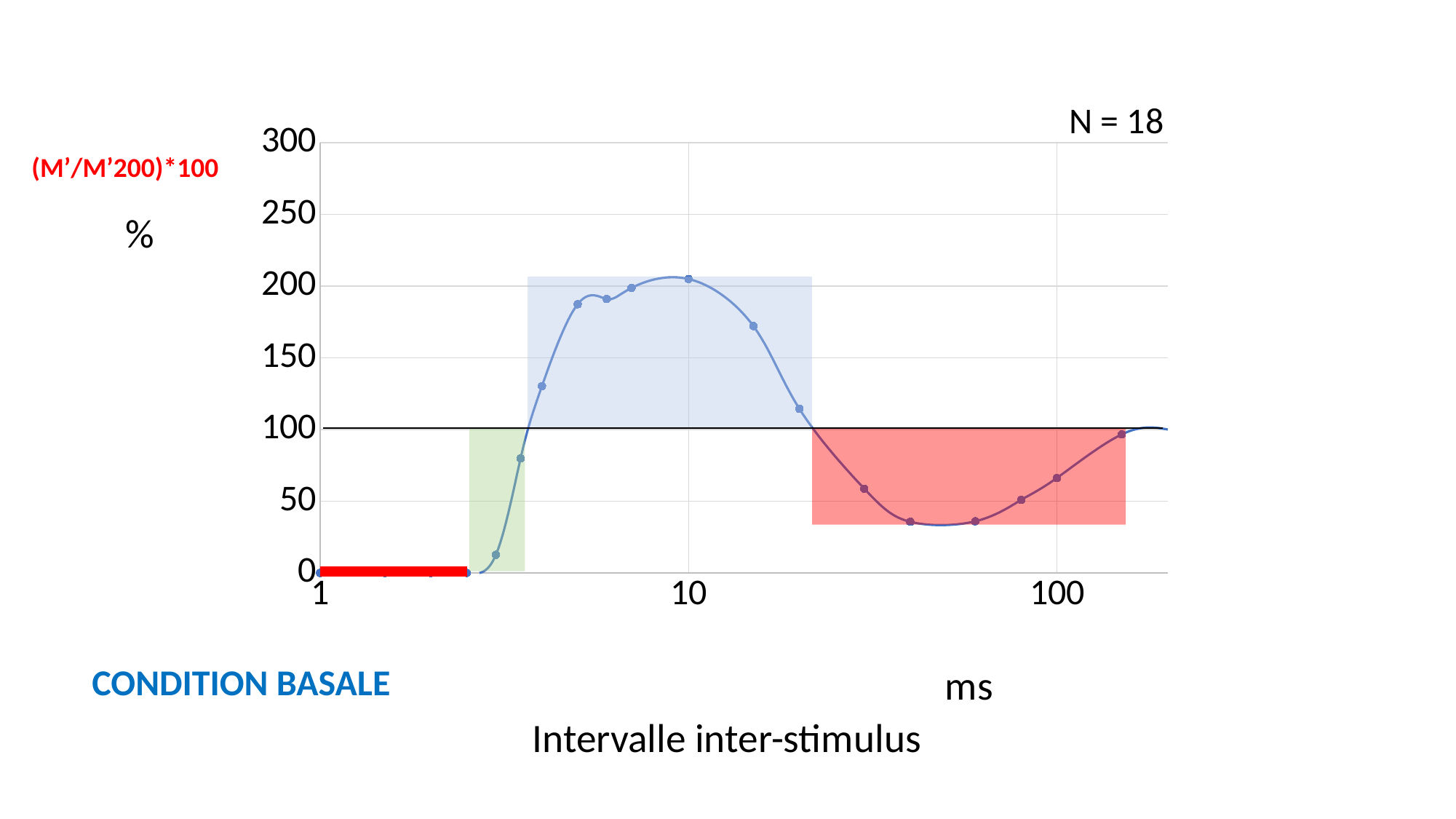
Which inter-stimulus interval has the higher value, 10 ms or 100 ms? 10 ms Do the values rise or fall as the inter-stimulus interval increases from 10 ms to 40 ms? fall Is the value at an inter-stimulus interval of 1 ms greater or less than 50? less What is the label of the x axis? Intervalle inter-stimulus What sample size (N) is stated on the slide? N = 18 Is the value at an inter-stimulus interval of 10 ms greater or less than 150? greater Is the value at an inter-stimulus interval of 100 ms greater or less than 100? less At which inter-stimulus interval on the x axis does the curve reach its highest value? 10 ms Which inter-stimulus interval has the higher value, 1 ms or 100 ms? 100 ms What kind of chart is shown on the slide? line chart Do the values rise or fall as the inter-stimulus interval increases from 3 ms to 10 ms? rise